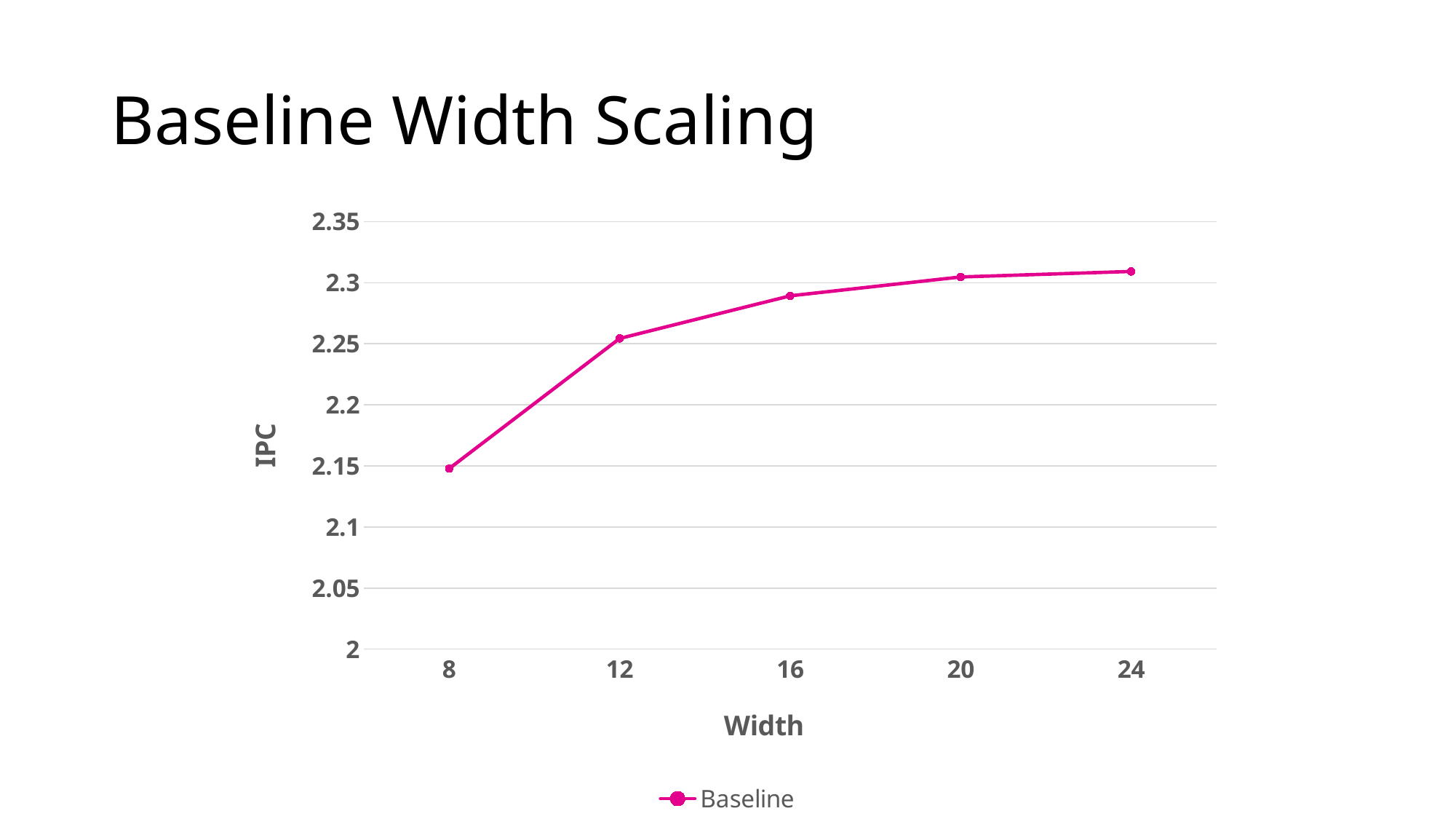
What is the label of the y axis? IPC What kind of chart is shown on the slide? line chart Which width has the lowest IPC? 8 Is the IPC value at width 8 greater or less than 2.2? less What is the title of the chart? Baseline Width Scaling How many data points are plotted on the Baseline line? 5 Is the IPC value at width 20 greater or less than 2.35? less Is the IPC value at width 16 greater or less than 2.25? greater Which has the higher IPC, width 8 or width 12? 12 Does IPC rise or fall as width increases from 8 to 24? rise How many series does the legend list? 1